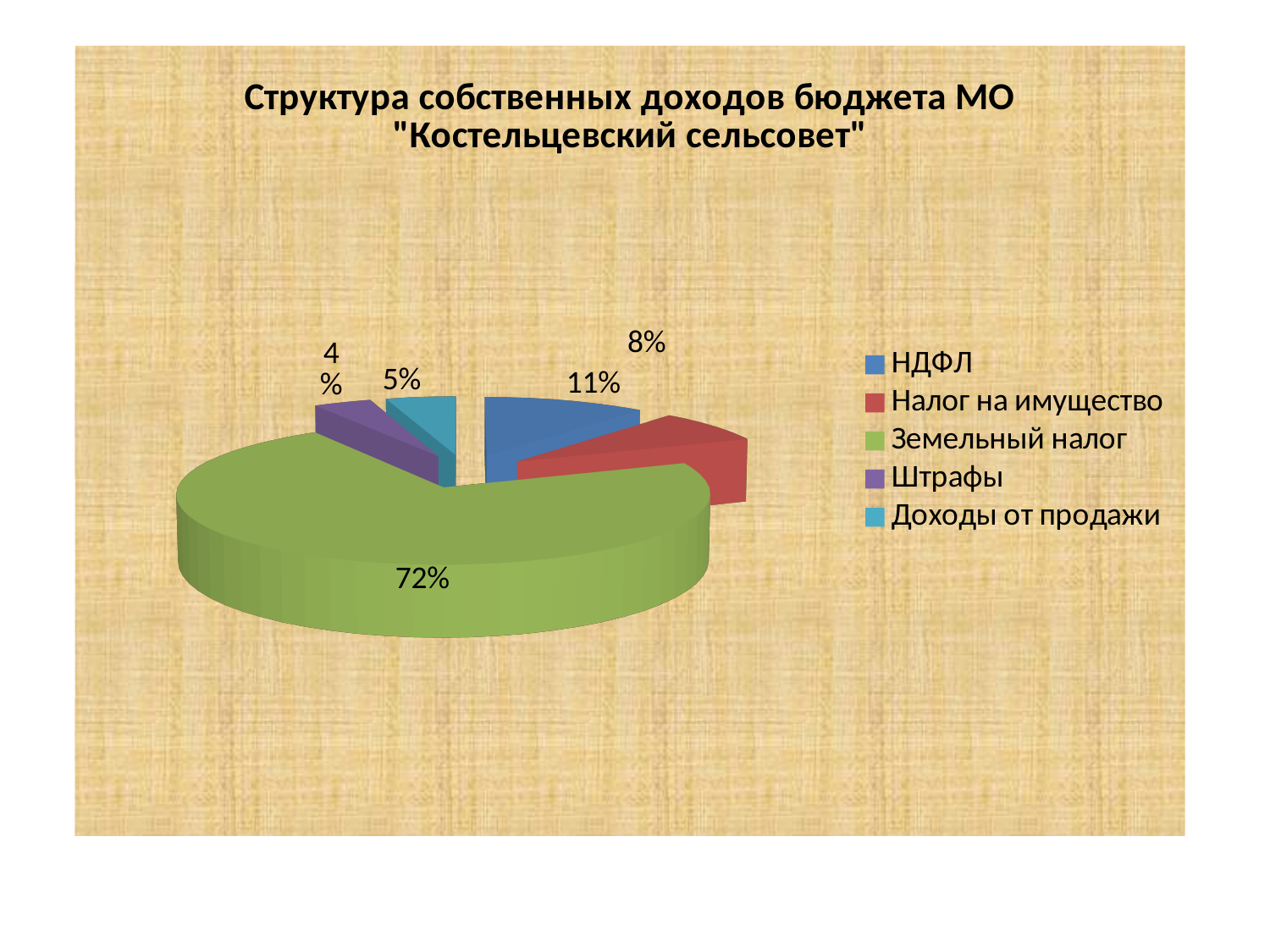
Which category has the largest share of the pie? Земельный налог What is the difference in percentage points between the shares of Земельный налог and НДФЛ? 61 What share of the pie does Налог на имущество have? 8% What share of the pie does НДФЛ have? 11% What kind of chart is shown on the slide? Pie chart Which category has the smallest share of the pie? Штрафы What share of the pie does Земельный налог have? 72% What share of the pie does Доходы от продажи have? 5% How many categories does the pie chart show? 5 What share of the pie does Штрафы have? 4% Which has a larger share, НДФЛ or Налог на имущество? НДФЛ Which colour represents Штрафы in the legend? Purple